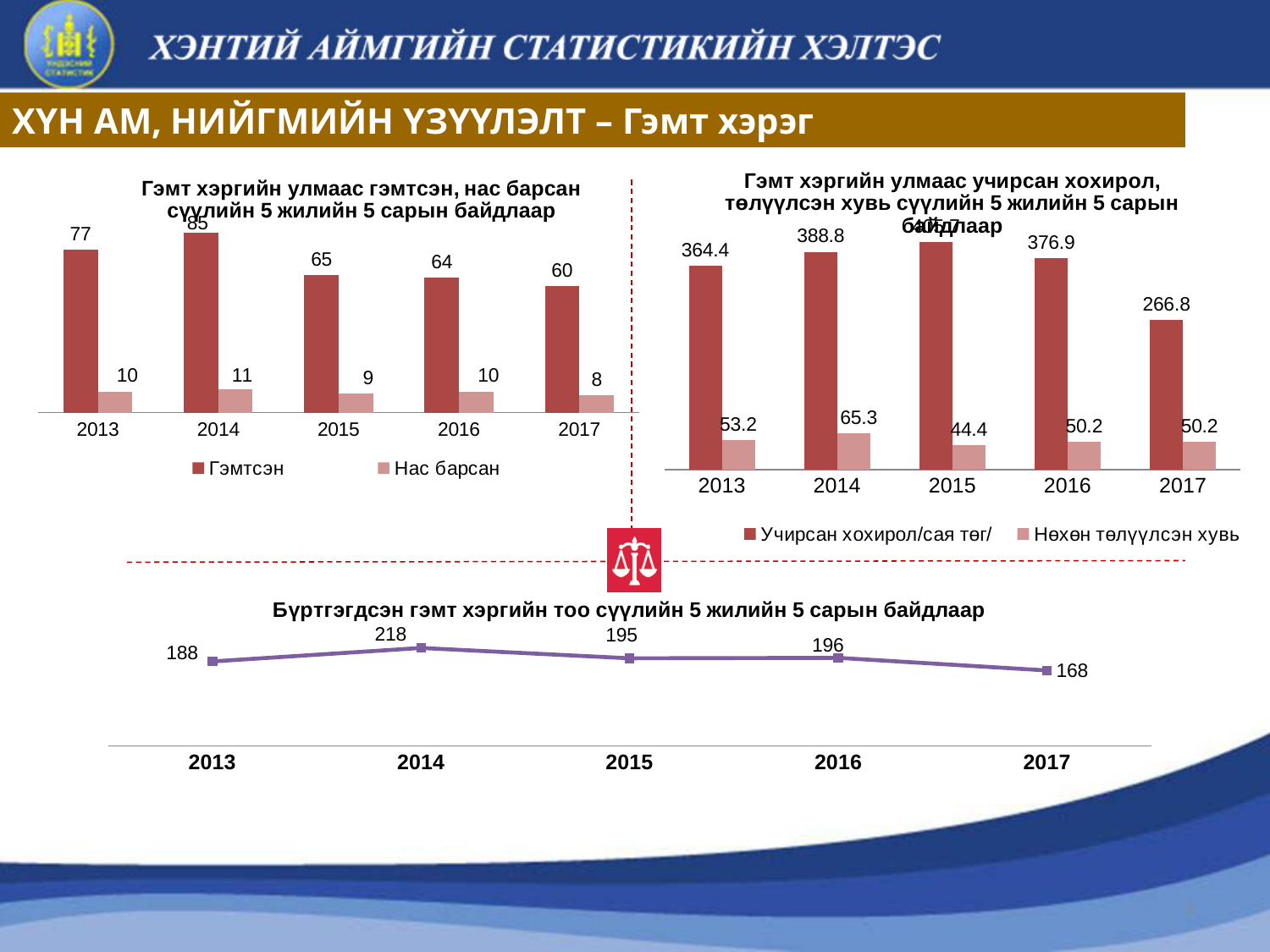
In the chart 'Гэмт хэргийн улмаас гэмтсэн, нас барсан сүүлийн 5 жилийн 5 сарын байдлаар', what is the value for Нас барсан in 2017? 8 In the chart 'Гэмт хэргийн улмаас гэмтсэн, нас барсан сүүлийн 5 жилийн 5 сарын байдлаар', which year has the lowest Гэмтсэн value? 2017 In the chart 'Гэмт хэргийн улмаас гэмтсэн, нас барсан сүүлийн 5 жилийн 5 сарын байдлаар', what is the difference between the Гэмтсэн values for 2013 and 2017? 17 In the chart 'Гэмт хэргийн улмаас гэмтсэн, нас барсан сүүлийн 5 жилийн 5 сарын байдлаар', how many series does the legend list? 2 In the bottom chart 'Бүртгэгдсэн гэмт хэргийн тоо сүүлийн 5 жилийн 5 сарын байдлаар', what is the difference between the values for 2016 and 2017? 28 In the top-right chart 'Гэмт хэргийн улмаас учирсан хохирол, төлүүлсэн хувь', which year has the lowest Нөхөн төлүүлсэн хувь value? 2015 What kind of chart is the bottom chart 'Бүртгэгдсэн гэмт хэргийн тоо сүүлийн 5 жилийн 5 сарын байдлаар'? line chart In the top-right chart 'Гэмт хэргийн улмаас учирсан хохирол, төлүүлсэн хувь', what is the value for Учирсан хохирол/сая төг/ in 2017? 266.8 In the top-right chart 'Гэмт хэргийн улмаас учирсан хохирол, төлүүлсэн хувь', is the Учирсан хохирол/сая төг/ value larger in 2013 or in 2014? 2014 In the top-right chart 'Гэмт хэргийн улмаас учирсан хохирол, төлүүлсэн хувь', what is the value for Нөхөн төлүүлсэн хувь in 2014? 65.3 In the chart 'Гэмт хэргийн улмаас гэмтсэн, нас барсан сүүлийн 5 жилийн 5 сарын байдлаар', what is the value for Гэмтсэн in 2014? 85 In the bottom chart 'Бүртгэгдсэн гэмт хэргийн тоо сүүлийн 5 жилийн 5 сарын байдлаар', what is the value for 2014? 218